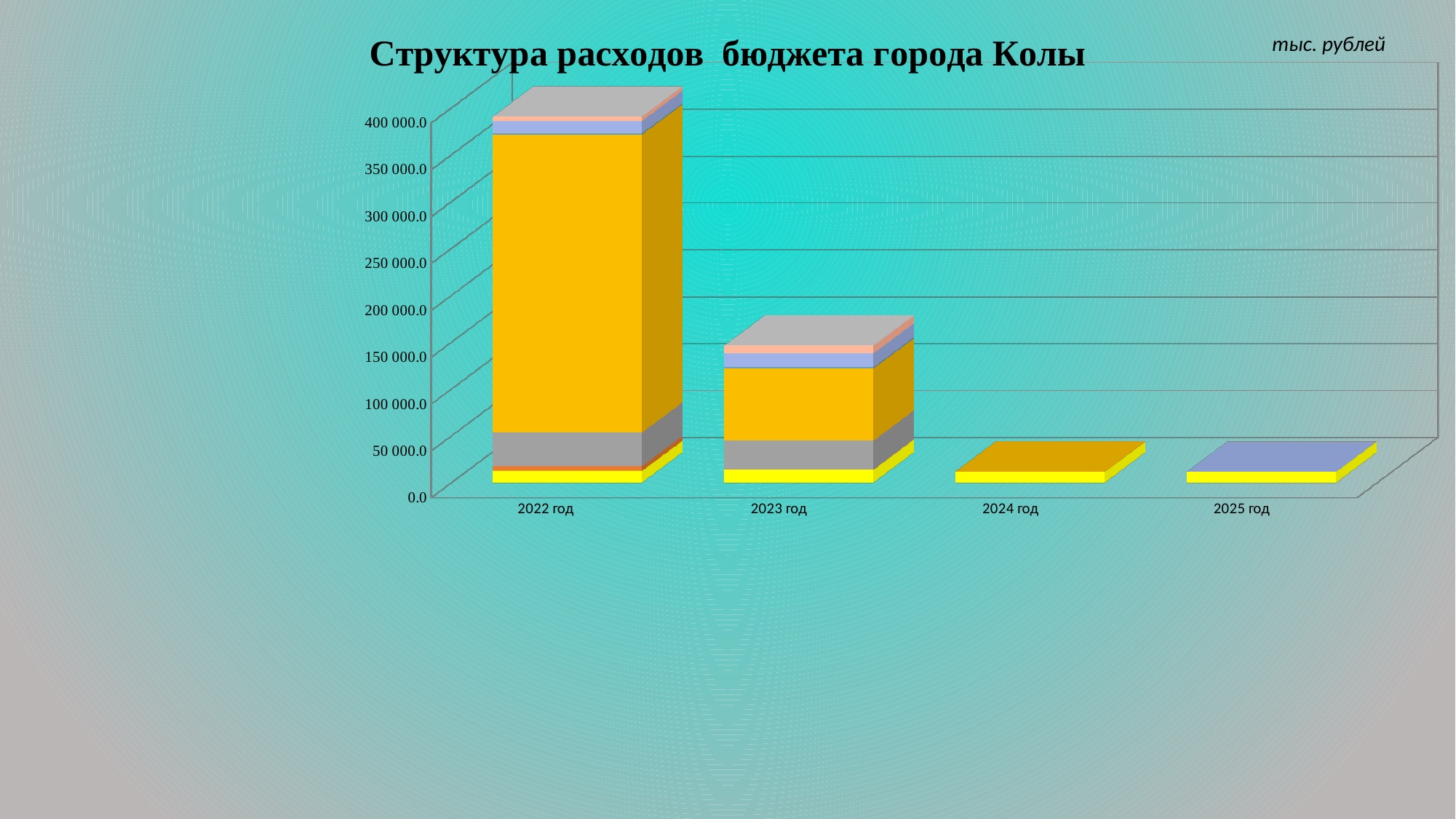
How many categories (years) are shown on the x axis? 4 In what units are the values on the chart expressed? тыс. рублей Is the total value for 2023 год greater or less than 200 000.0? less What kind of chart is shown on the slide? Stacked bar chart Is the total value for 2023 год greater or less than 100 000.0? greater Which is larger, the total for 2022 год or the total for 2023 год? 2022 год Is the total value for 2022 год greater or less than 350 000.0? greater Which is larger, the total for 2023 год or the total for 2024 год? 2023 год What is the title of the chart? Структура расходов бюджета города Колы Which year has the highest total bar? 2022 год Do the total bar values rise or fall from 2022 год to 2025 год? fall